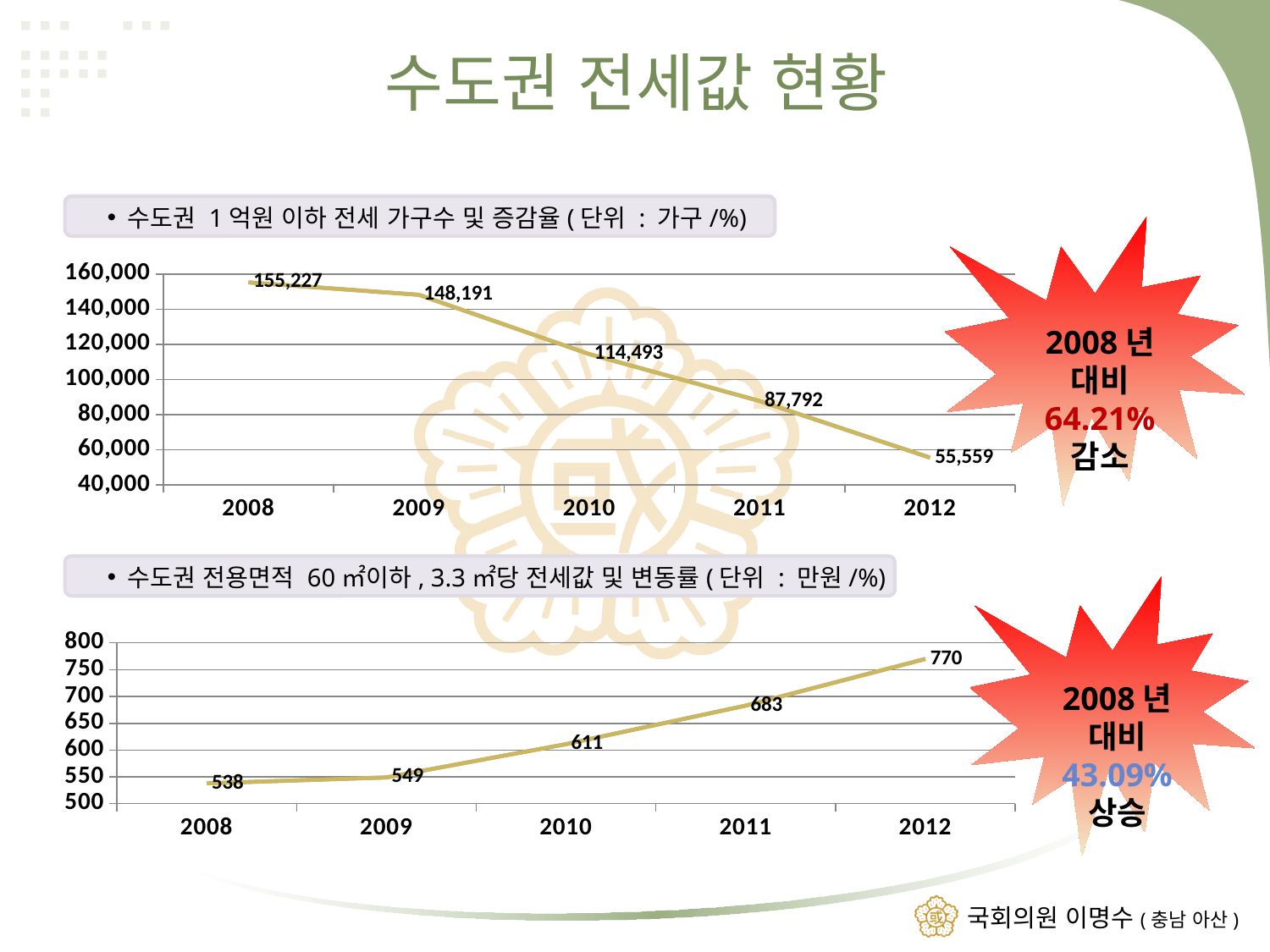
In the top chart (수도권 1억원 이하 전세 가구수), which year has the lowest value? 2012 In the top chart (수도권 1억원 이하 전세 가구수), what is the value for 2008? 155,227 In the top chart (수도권 1억원 이하 전세 가구수), do the values rise or fall from 2008 to 2012? fall In the bottom chart (수도권 전용면적 60㎡이하 3.3㎡당 전세값), what is the value for 2010? 611 In the bottom chart (수도권 전용면적 60㎡이하 3.3㎡당 전세값), which year has the highest value? 2012 In the top chart (수도권 1억원 이하 전세 가구수), how many years are plotted? 5 What type of chart is the top chart on the slide? line chart In the bottom chart (수도권 전용면적 60㎡이하 3.3㎡당 전세값), what is the difference between the 2012 and 2008 values? 232 In the bottom chart (수도권 전용면적 60㎡이하 3.3㎡당 전세값), do the values rise or fall from 2008 to 2012? rise In the top chart (수도권 1억원 이하 전세 가구수), what is the value for 2012? 55,559 In the bottom chart (수도권 전용면적 60㎡이하 3.3㎡당 전세값), which is larger, the value for 2011 or the value for 2009? 2011 In the top chart (수도권 1억원 이하 전세 가구수), what is the difference between the 2008 and 2012 values? 99,668